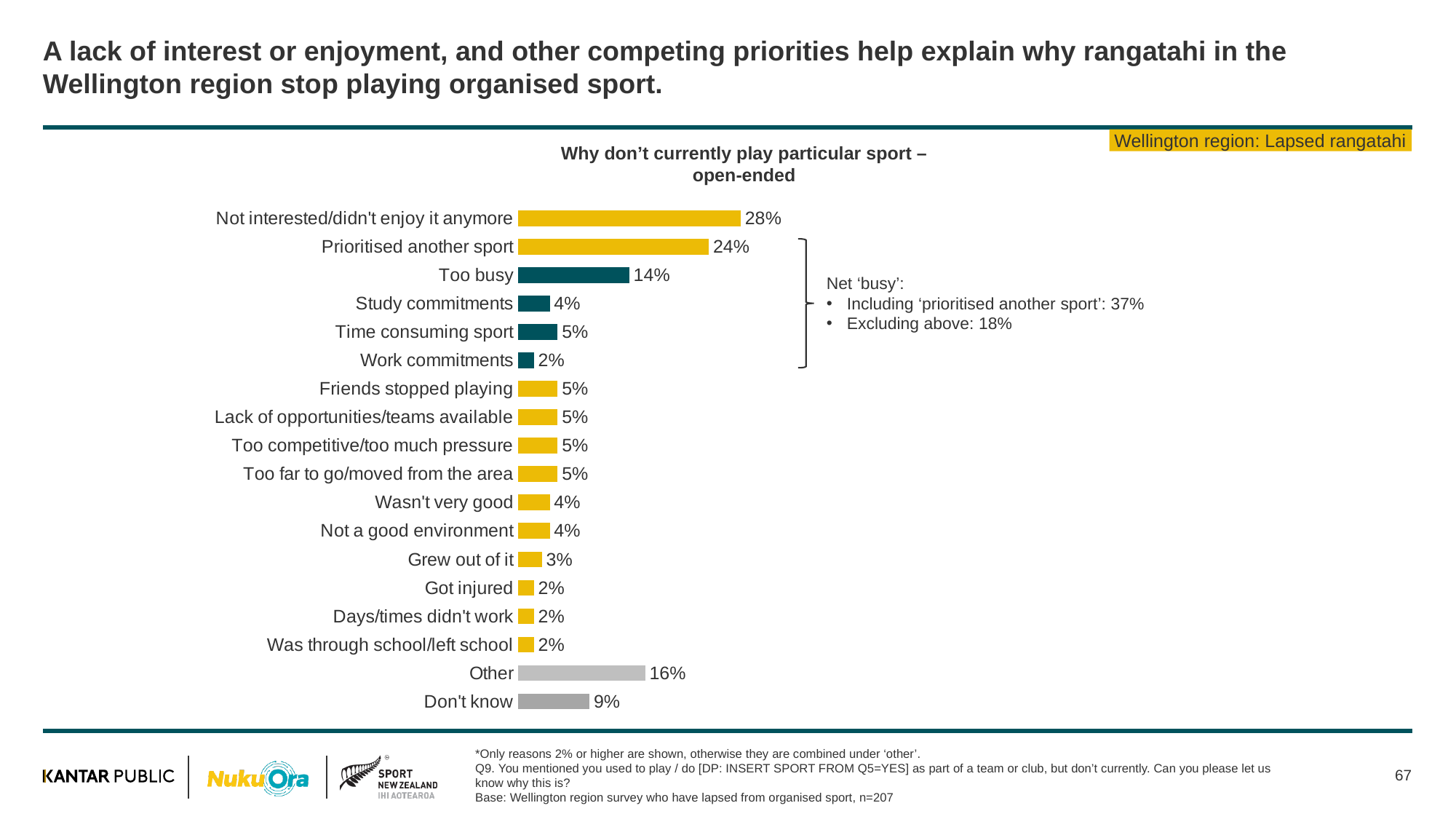
How many reason categories (bars) are shown in the chart? 18 What value is shown for 'Too busy'? 14% Which reason has the highest percentage in the chart? Not interested/didn't enjoy it anymore According to the annotation, what is the net 'busy' percentage including 'prioritised another sport'? 37% What type of chart is shown on the slide? Bar chart What percentage is shown for 'Don't know'? 9% Which is larger: the value for 'Other' or the value for 'Too busy'? Other What percentage is shown for 'Other'? 16% Which is larger: the value for 'Grew out of it' or the value for 'Friends stopped playing'? Friends stopped playing What is the difference in percentage points between 'Too busy' and 'Study commitments'? 10 What is the difference in percentage points between 'Not interested/didn't enjoy it anymore' and 'Prioritised another sport'? 4 What percentage of lapsed rangatahi said they were not interested/didn't enjoy it anymore? 28%